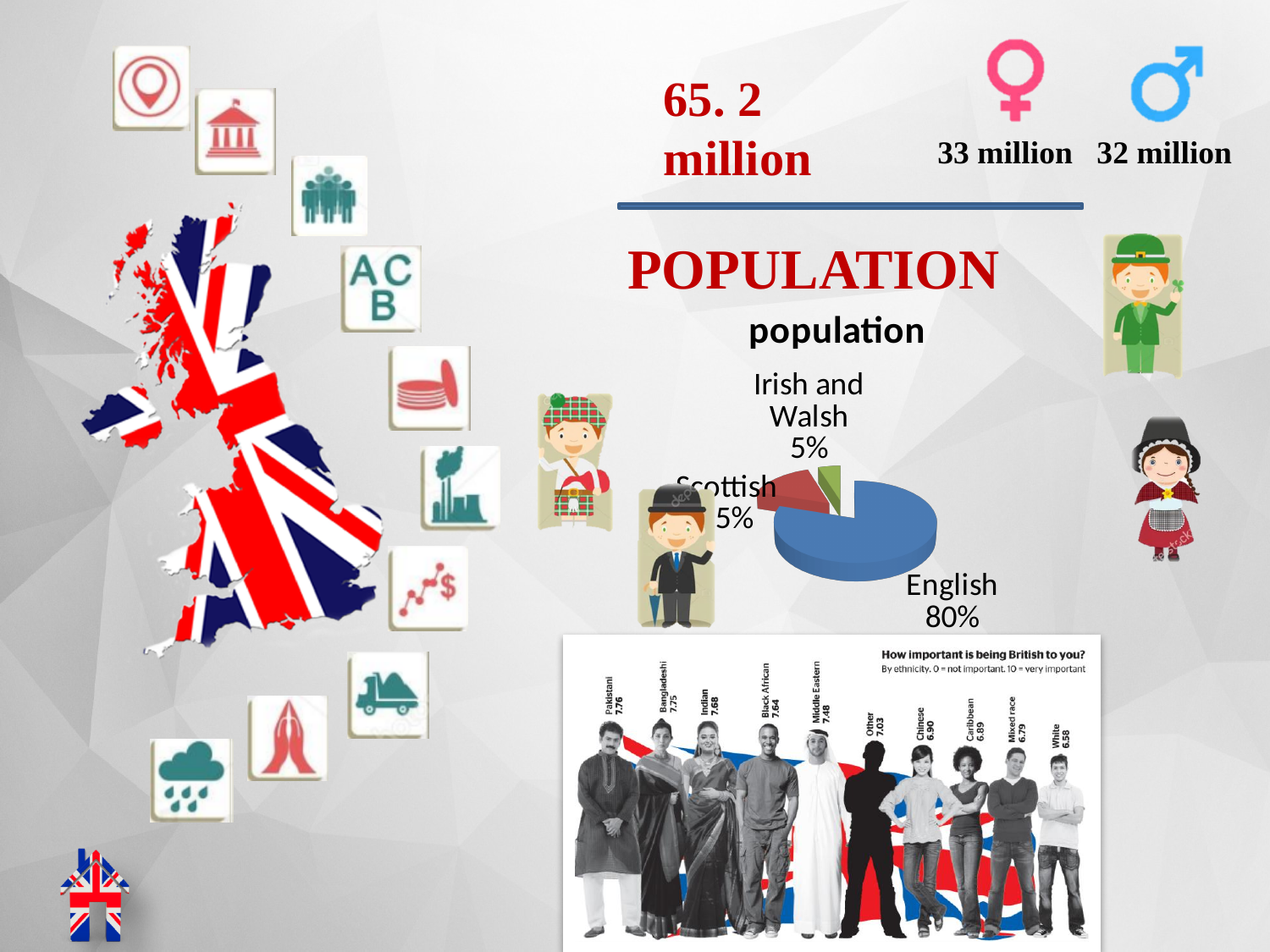
In the pie chart titled "population", what share is labelled for English? 80% In the pie chart titled "population", which is larger, the English share or the Irish and Walsh share? English In the pie chart titled "population", what is the difference between the English share and the Scottish share? 65% In the pie chart titled "population", what colour is the English slice? blue In the infographic titled "How important is being British to you?", how many ethnic groups are shown? 10 In the infographic titled "How important is being British to you?", what is the value for White? 6.58 In the pie chart titled "population", which labelled group has the largest share? English In the pie chart titled "population", what share is labelled for Irish and Walsh? 5% In the infographic titled "How important is being British to you?", which ethnicity has the lowest value? White What kind of chart is the chart titled "population"? pie chart In the infographic titled "How important is being British to you?", what is the value for Pakistani? 7.76 In the pie chart titled "population", what share is labelled for Scottish? 15%